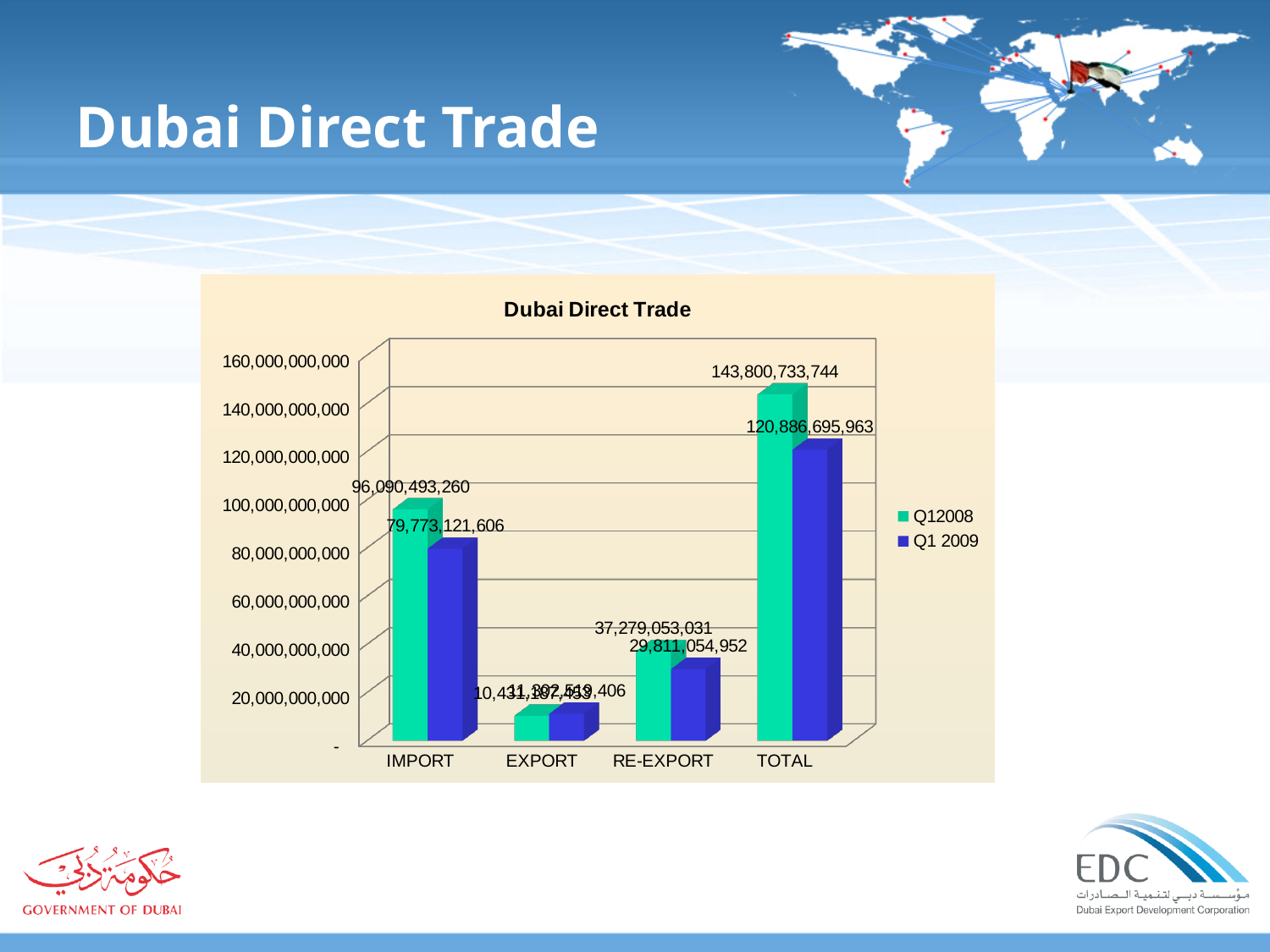
What is the Q12008 value for RE-EXPORT? 37,279,053,031 How many categories are shown on the x axis? 4 What is the difference between the Q12008 and Q1 2009 values for TOTAL? 22,914,037,781 What is the title of the chart? Dubai Direct Trade What is the Q1 2009 value for IMPORT? 79,773,121,606 What is the Q12008 value for TOTAL? 143,800,733,744 What type of chart is shown on the slide? bar chart Which category has the highest Q1 2009 value? TOTAL Which category has the lowest Q12008 value? EXPORT Which is larger for IMPORT, the Q12008 value or the Q1 2009 value? Q12008 Is the Q12008 value for EXPORT greater or less than 20,000,000,000? less How many series does the legend list? 2